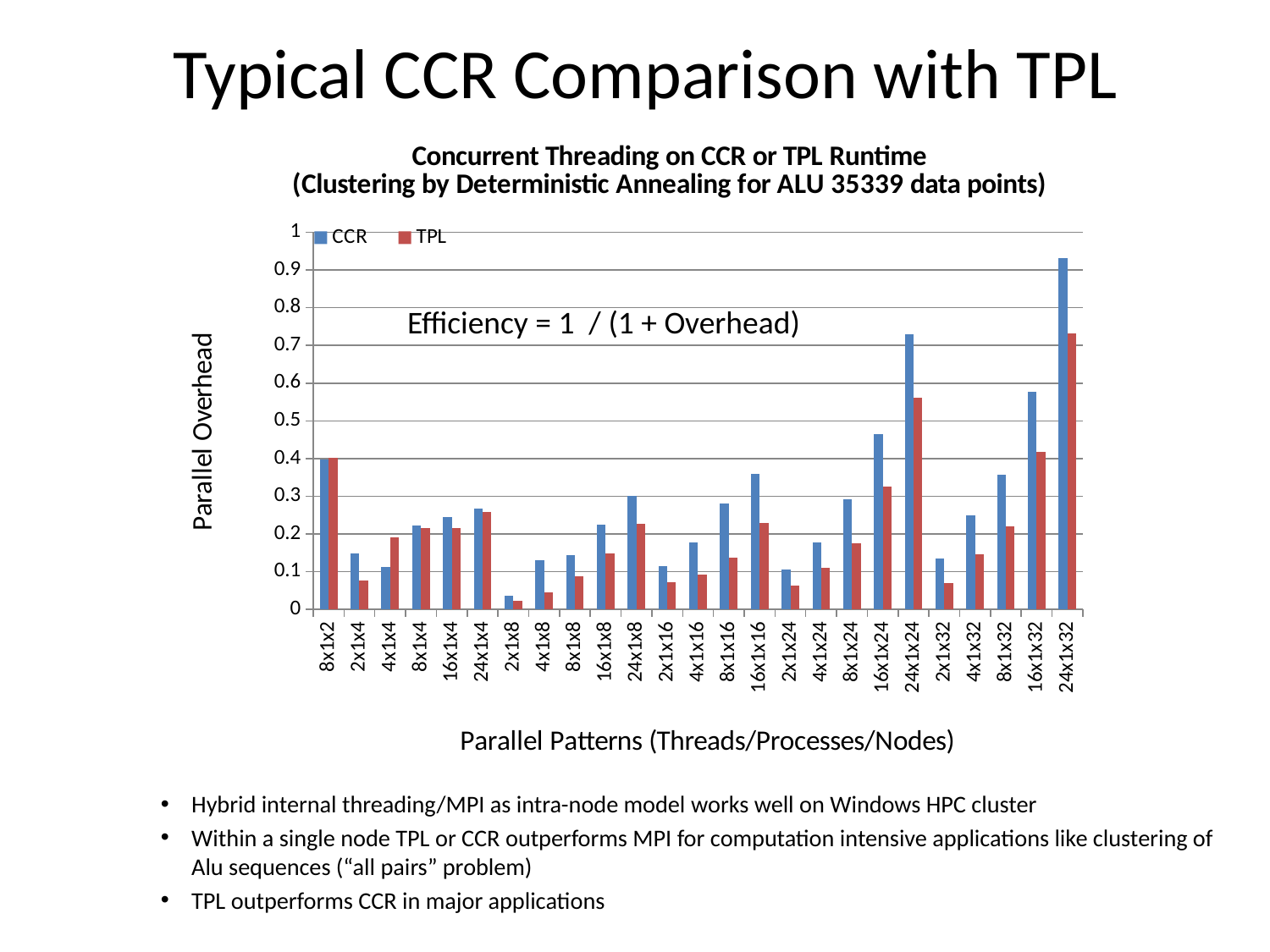
What is the label of the y axis? Parallel Overhead Is the TPL value for 24x1x24 greater or less than 0.5? greater Which parallel pattern has the highest CCR parallel overhead? 24x1x32 Which parallel pattern has the lowest CCR parallel overhead? 2x1x8 How many parallel pattern categories are shown on the x axis? 25 Is the TPL value for 2x1x4 greater or less than 0.1? less Is the CCR value for 16x1x32 greater or less than 0.5? greater How many series does the legend list? 2 What type of chart is shown on the slide? bar chart For the 16x1x16 pattern, which series has the larger parallel overhead, CCR or TPL? CCR Which parallel pattern has the highest TPL parallel overhead? 24x1x32